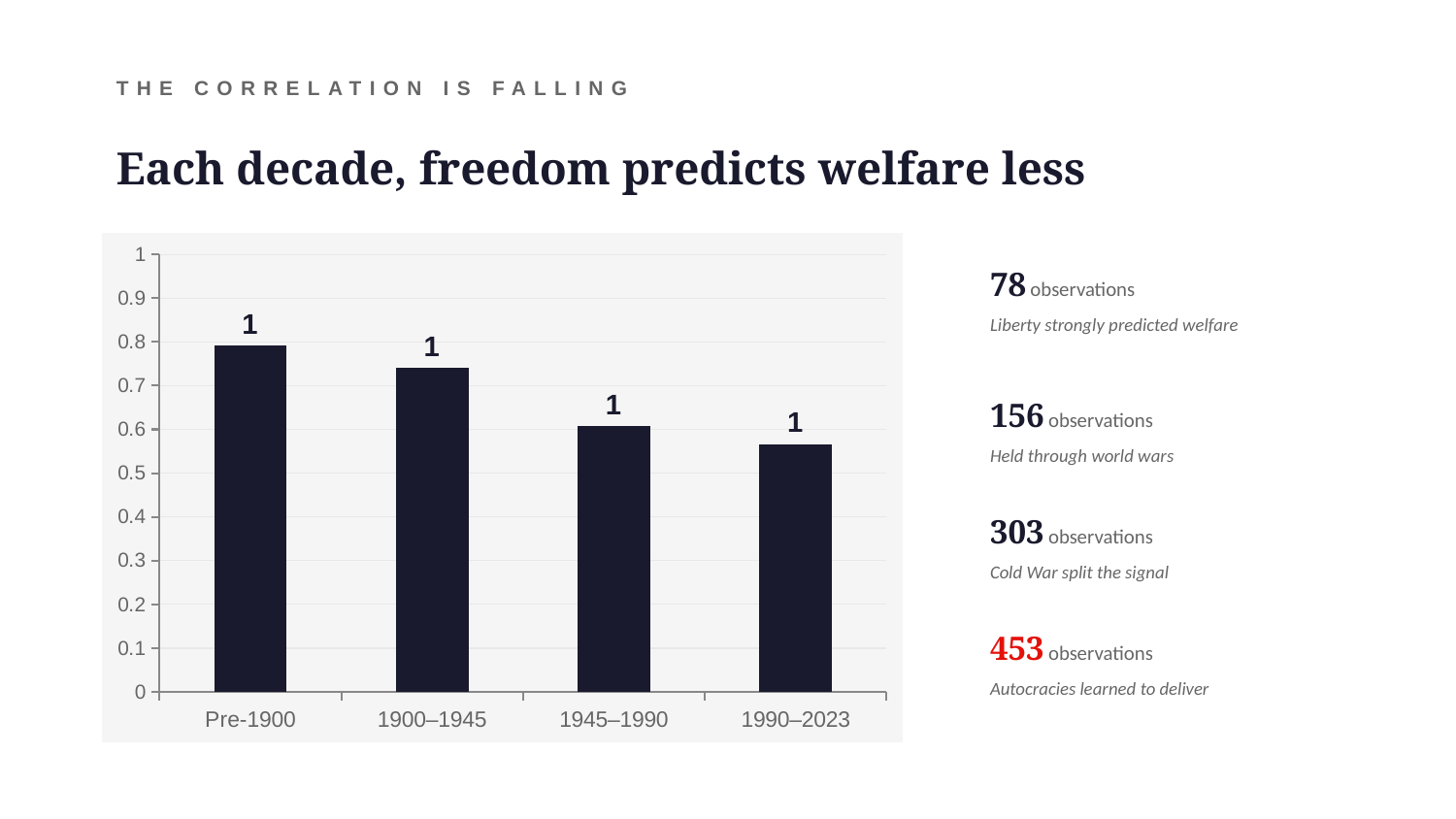
Is the value for 1990–2023 greater or less than 0.7? less What is the title of the slide above the chart? Each decade, freedom predicts welfare less Which bar is taller, 1900–1945 or 1990–2023? 1900–1945 What kind of chart is shown on the slide? bar chart Do the bar values rise or fall from Pre-1900 to 1990–2023? fall How many categories are shown on the x axis of the chart? 4 Is the value for Pre-1900 greater or less than 0.7? greater Is the value for 1945–1990 greater or less than 0.5? greater Which category has the highest bar in the chart? Pre-1900 Which category has the lowest bar in the chart? 1990–2023 Which bar is taller, Pre-1900 or 1945–1990? Pre-1900